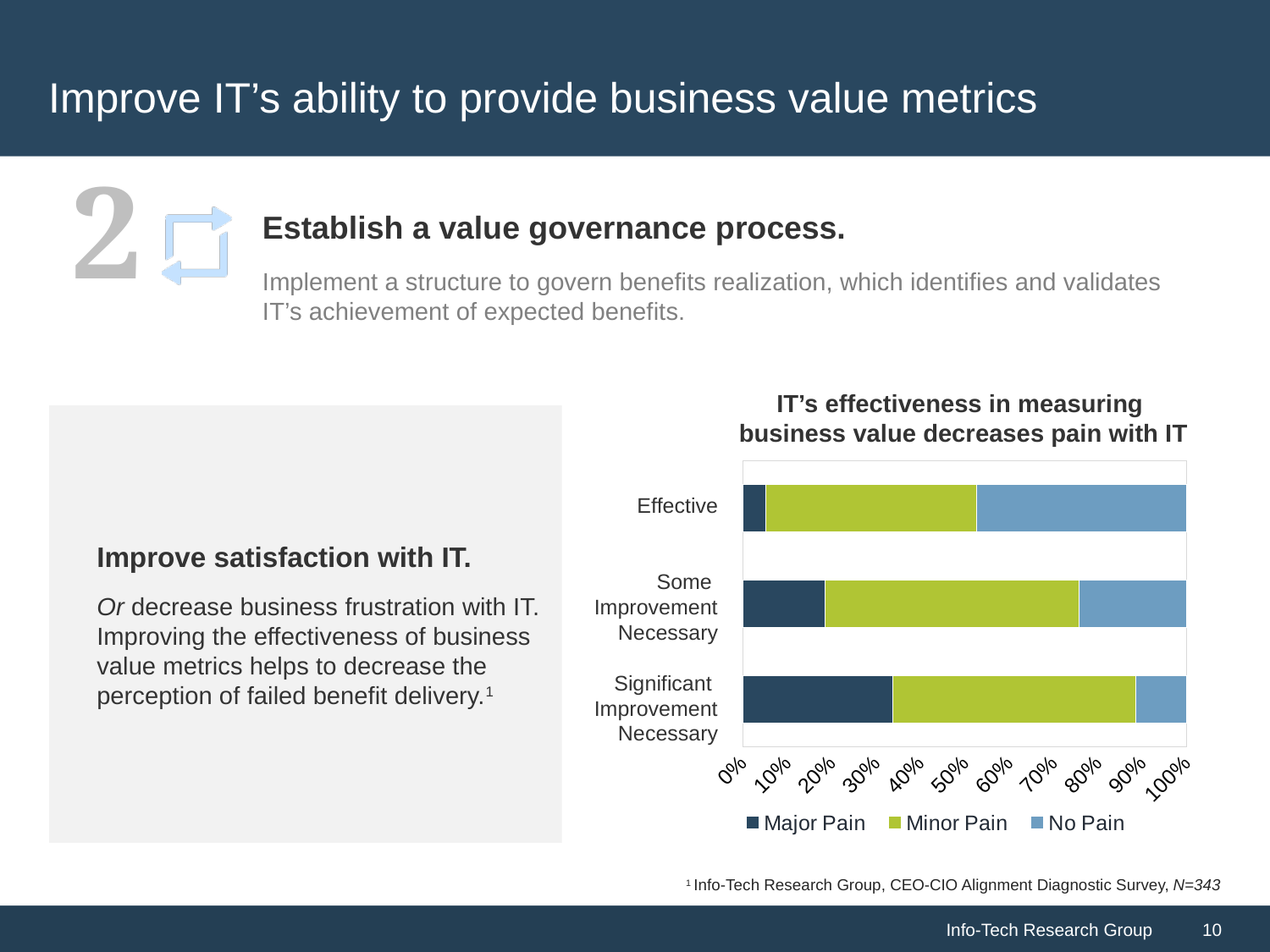
What kind of chart is shown on the slide? Stacked bar chart Which category has the smallest No Pain segment? Significant Improvement Necessary Does the Major Pain share rise or fall moving from Effective down to Significant Improvement Necessary? rise Is the Major Pain value for Significant Improvement Necessary greater or less than 20%? greater What is the title of the chart? IT's effectiveness in measuring business value decreases pain with IT Is the Major Pain value for Effective greater or less than 10%? less How many series does the chart's legend list? 3 Is the Major Pain segment larger for Effective or for Significant Improvement Necessary? Significant Improvement Necessary How many categories are shown on the chart's vertical axis? 3 Which series is shown in green in the chart? Minor Pain Which category has the largest Major Pain segment? Significant Improvement Necessary Is the No Pain segment for Significant Improvement Necessary greater or less than 20%? less